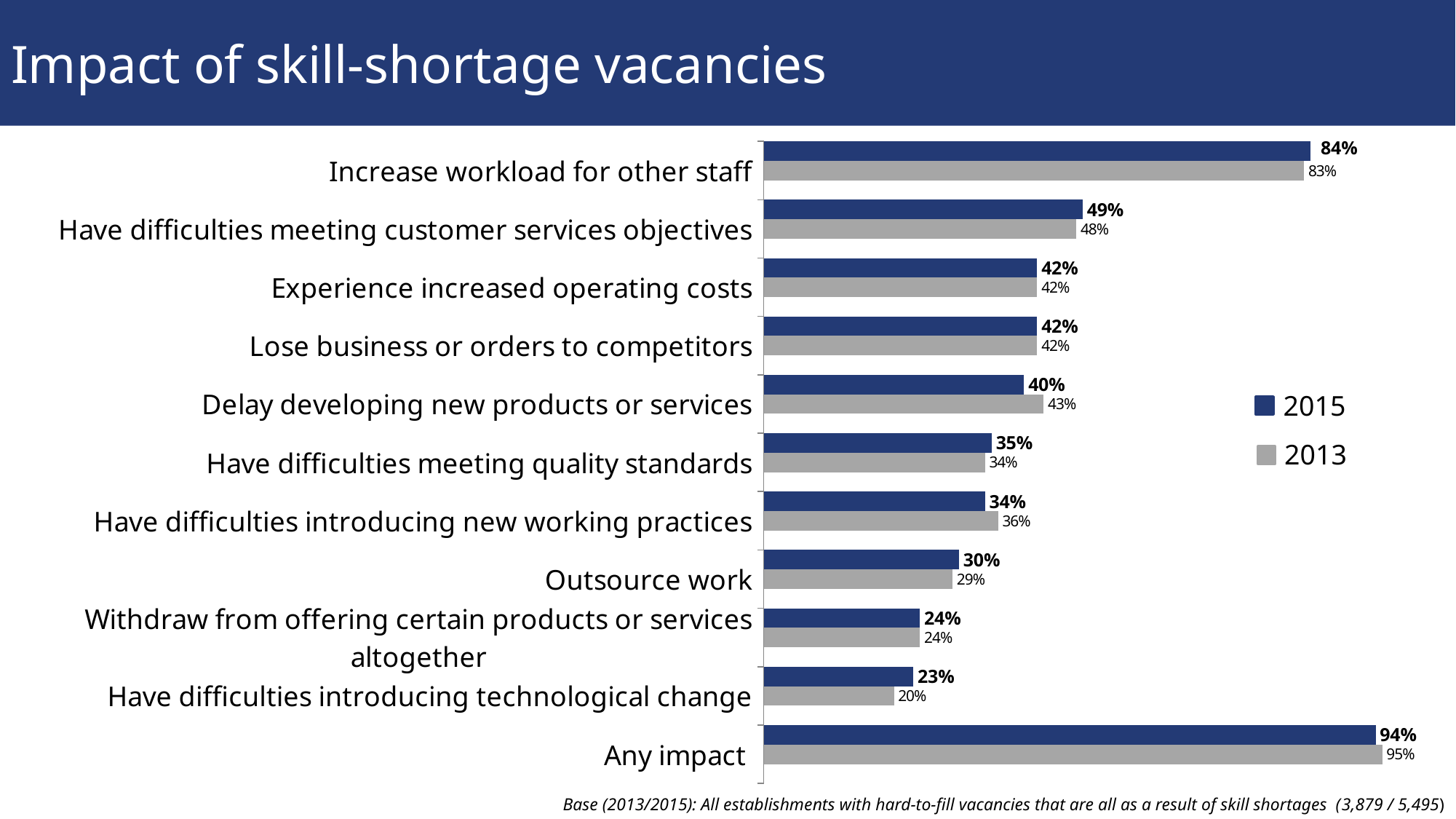
Which category has the highest 2015 value? Any impact What is the 2013 value for "Have difficulties introducing technological change"? 20% What is the 2015 value for "Delay developing new products or services"? 40% What is the 2013 value for "Outsource work"? 29% What is the 2015 value for "Increase workload for other staff"? 84% How many series does the legend list? 2 Which series is shown in grey in the legend? 2013 Which category has the lowest 2013 value? Have difficulties introducing technological change For "Delay developing new products or services", which year has the larger value, 2015 or 2013? 2013 What is the difference between the 2015 and 2013 values for "Have difficulties introducing technological change"? 3% What kind of chart is shown on the slide? Bar chart How many categories are shown on the chart? 11